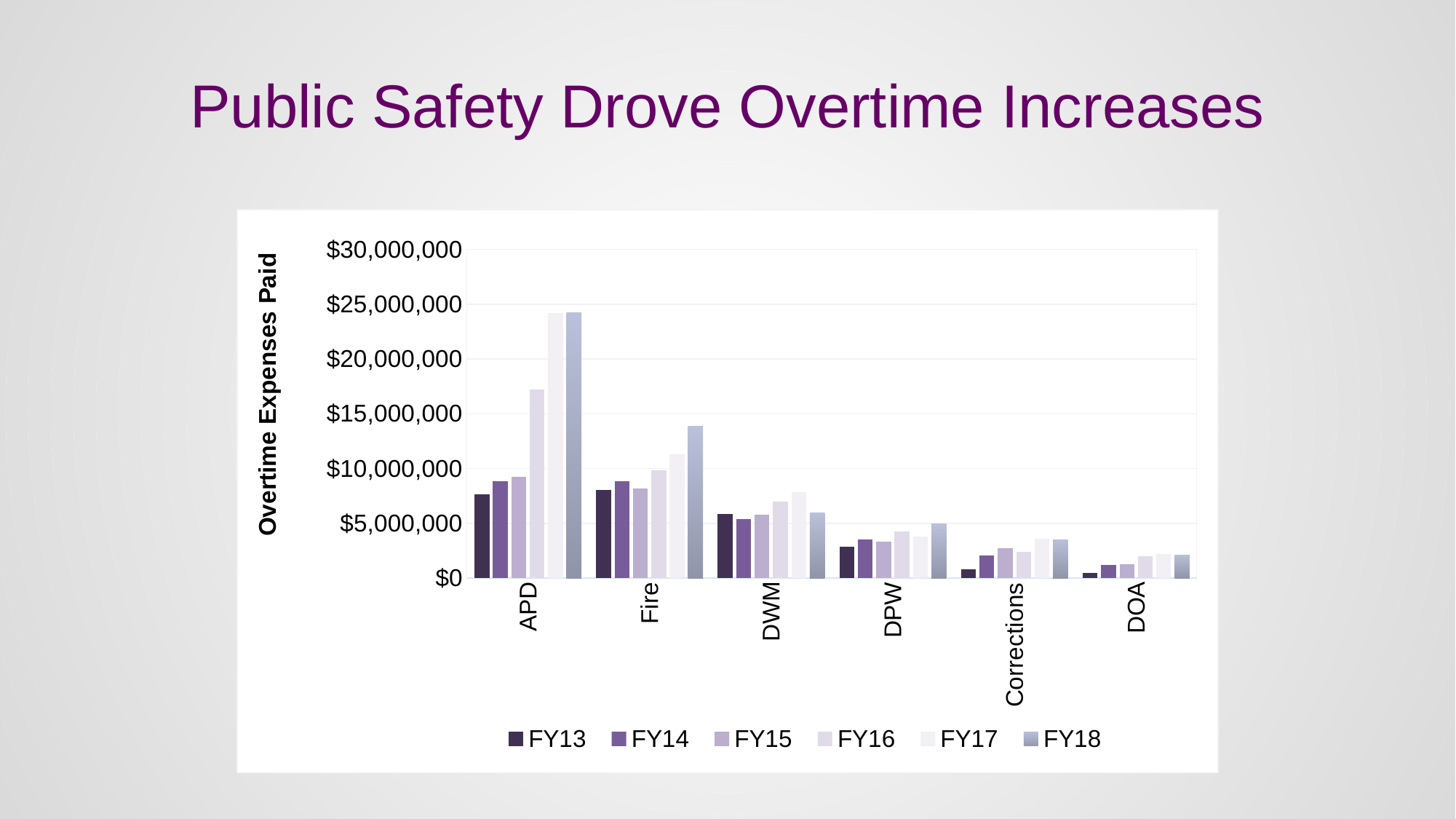
Is the FY17 value for APD greater or less than $20,000,000? greater How many departments are shown on the x axis? 6 Which department has the lowest FY13 overtime expenses? DOA Which is larger, the FY18 value for Fire or the FY18 value for DWM? Fire How many series does the legend list? 6 Is the FY13 value for Corrections greater or less than $5,000,000? less Is the FY16 value for APD greater or less than $15,000,000? greater What is the title of the vertical axis? Overtime Expenses Paid What kind of chart is shown on the slide? bar chart Do the APD overtime expenses rise or fall from FY13 to FY18? rise Which department has the highest FY18 overtime expenses? APD